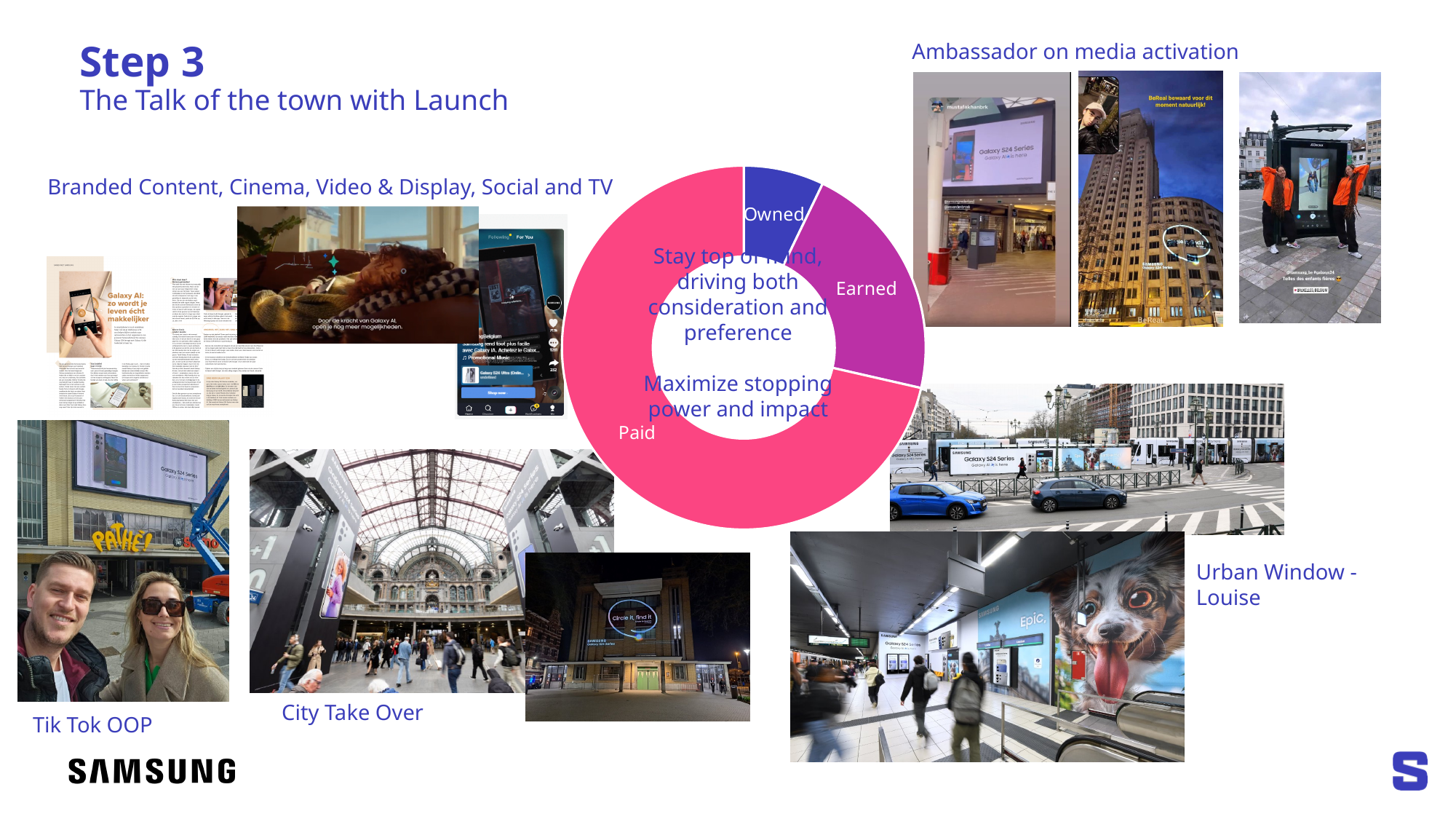
What are the labels of the three slices in the doughnut chart? Owned, Earned, Paid In the doughnut chart, which slice is larger, Paid or Earned? Paid What kind of chart is shown in the centre of the slide? Doughnut chart Does the Paid slice take up more or less than half of the doughnut chart? More How many slices does the doughnut chart have? 3 In the doughnut chart, which slice is larger, Earned or Owned? Earned What colour is the Paid slice in the doughnut chart? Pink Which slice of the doughnut chart is the smallest? Owned Which slice of the doughnut chart is the largest? Paid